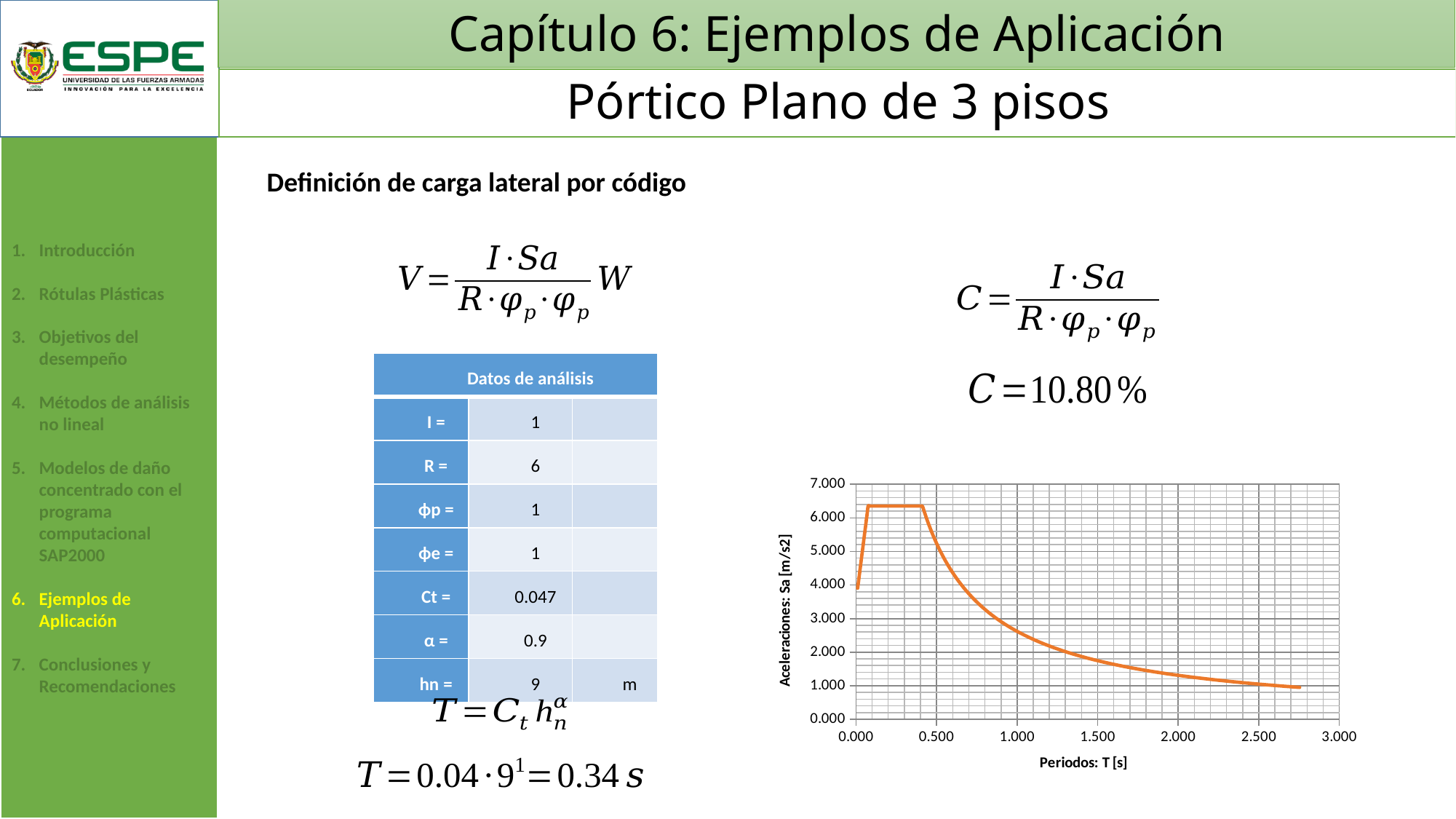
What is the label of the x axis of the chart? Periodos: T [s] Is the value of Sa at T = 0.000 s greater or less than 3.000? greater How many lines are plotted on the chart? 1 What is the label of the y axis of the chart? Aceleraciones: Sa [m/s2] Is the maximum value of Sa on the chart greater or less than 7.000? less Which is larger, the value of Sa at T = 0.250 s or at T = 1.000 s? T = 0.250 s Is the value of Sa at T = 2.000 s greater or less than 2.000? less Do the Sa values rise or fall as T increases from 0.500 s to 2.750 s? fall What kind of chart is shown on the slide? line chart